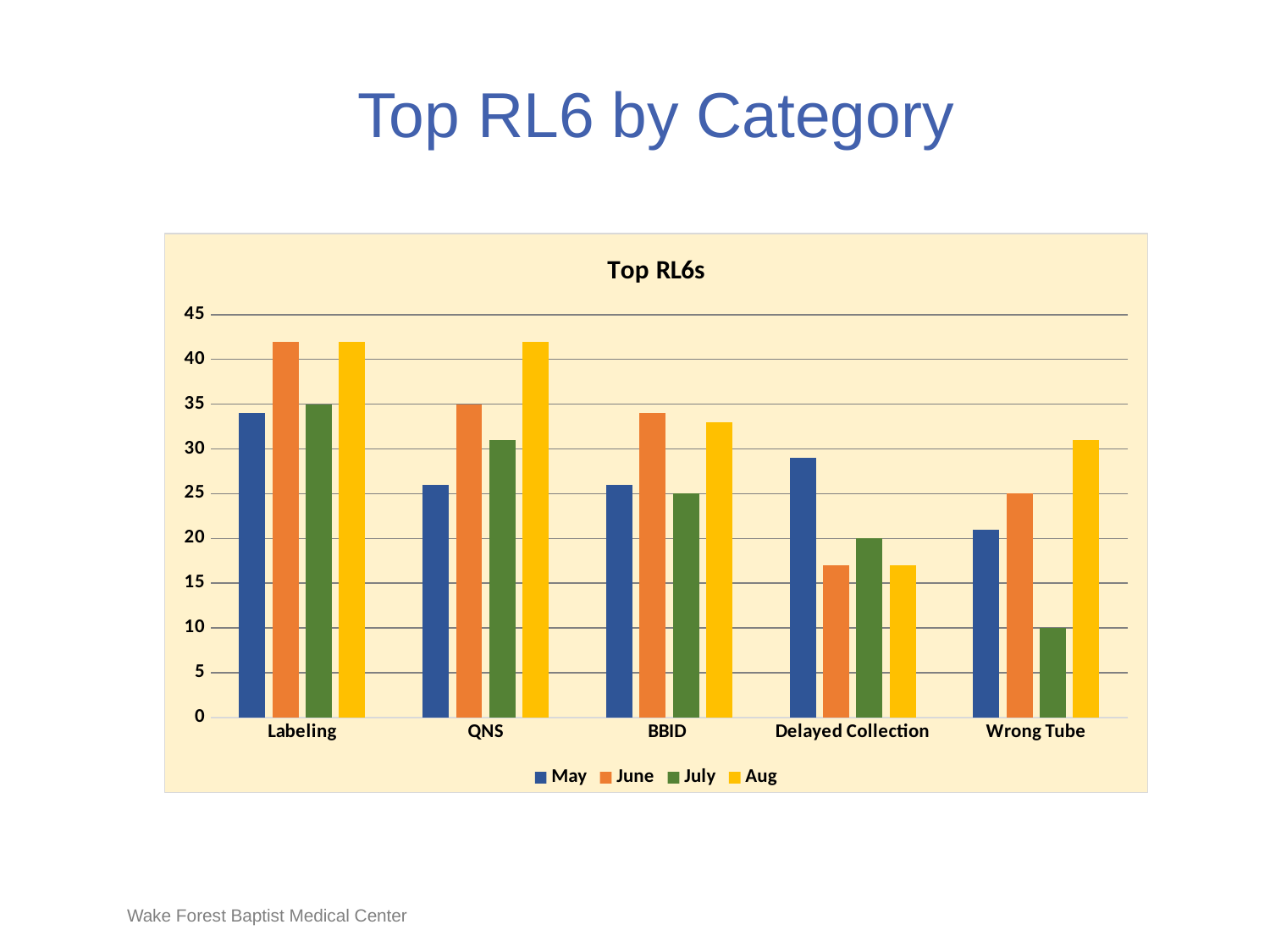
What is the value for July in the Delayed Collection category? 20 What is the title shown inside the chart? Top RL6s What is the value for July in the Wrong Tube category? 10 Which is larger, the May value for Labeling or the May value for Delayed Collection? Labeling How many categories are shown on the x axis? 5 Is the value for Aug in the Wrong Tube category greater or less than 25? greater How many series does the legend list? 4 Which category has the lowest bar in the chart? Wrong Tube What kind of chart is shown on the slide? bar chart Is the value for June in the Labeling category greater or less than 40? greater Is the value for June in the Delayed Collection category greater or less than 20? less